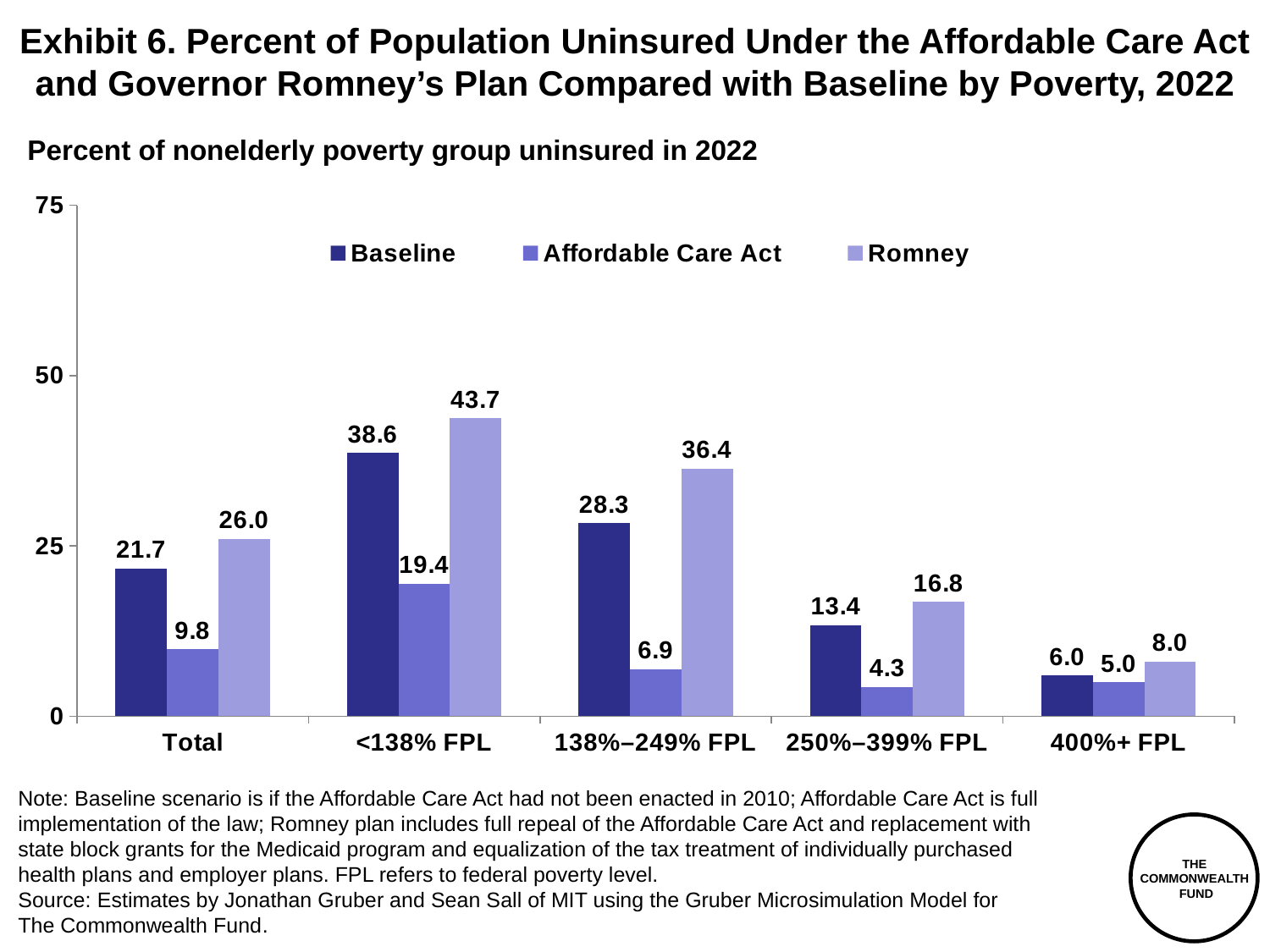
What is the difference between the Romney and Affordable Care Act values for the 138%–249% FPL group? 29.5 Which poverty group has the highest Romney value? <138% FPL Which series is shown in the darkest colour in the legend? Baseline What is the Romney value for the <138% FPL group? 43.7 What is the Affordable Care Act value for the Total category? 9.8 Which poverty group has the lowest Affordable Care Act value? 250%–399% FPL How many categories are shown on the x axis? 5 What kind of chart is shown on the slide? Bar chart Is the Baseline value for the <138% FPL group greater or less than 25? greater What is the Baseline value for the 250%–399% FPL group? 13.4 How many series does the legend list? 3 Which is larger for the 400%+ FPL group, the Baseline value or the Affordable Care Act value? Baseline